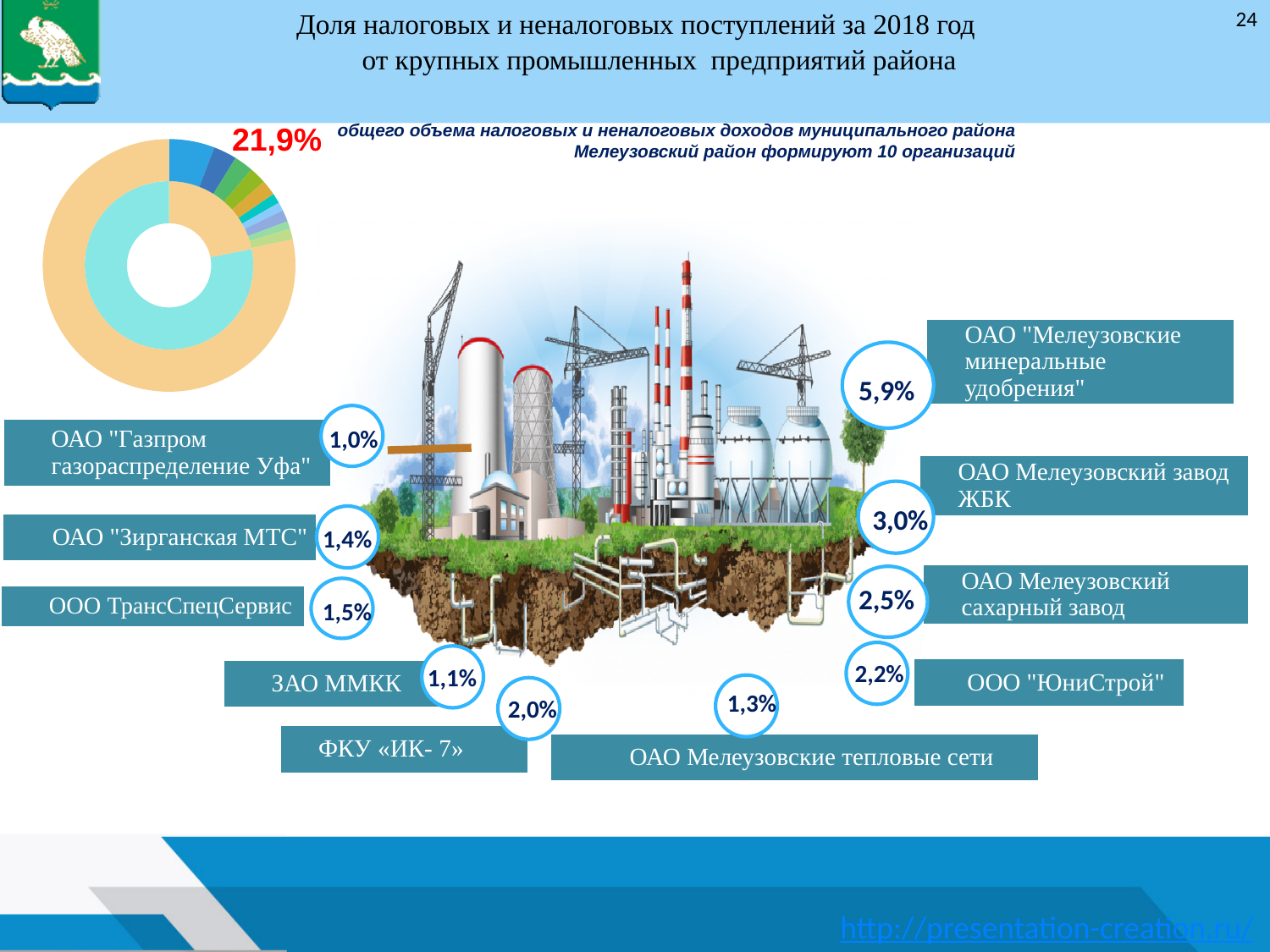
Which organization has the largest share of revenue on the slide? ОАО "Мелеузовские минеральные удобрения" For which year does the slide show the share of tax and non-tax revenue? 2018 What is the difference between the shares of ОАО "Мелеузовские минеральные удобрения" and ОАО Мелеузовский завод ЖБК? 2,9% What share of tax and non-tax revenue is attributed to ОАО "Мелеузовские минеральные удобрения"? 5,9% Which has a larger share: ОАО Мелеузовский завод ЖБК or ОАО Мелеузовский сахарный завод? ОАО Мелеузовский завод ЖБК What share is shown for ФКУ «ИК-7»? 2,0% What is the combined share of the 10 organizations in the district's total tax and non-tax revenue? 21,9% Which organization has the smallest share of revenue on the slide? ОАО "Газпром газораспределение Уфа" What share is shown for ОАО Мелеузовский завод ЖБК? 3,0% What kind of chart is shown on the slide? pie (donut) chart What share is shown for ОАО Мелеузовские тепловые сети? 1,3% How many organizations are listed with their revenue shares on the slide? 10